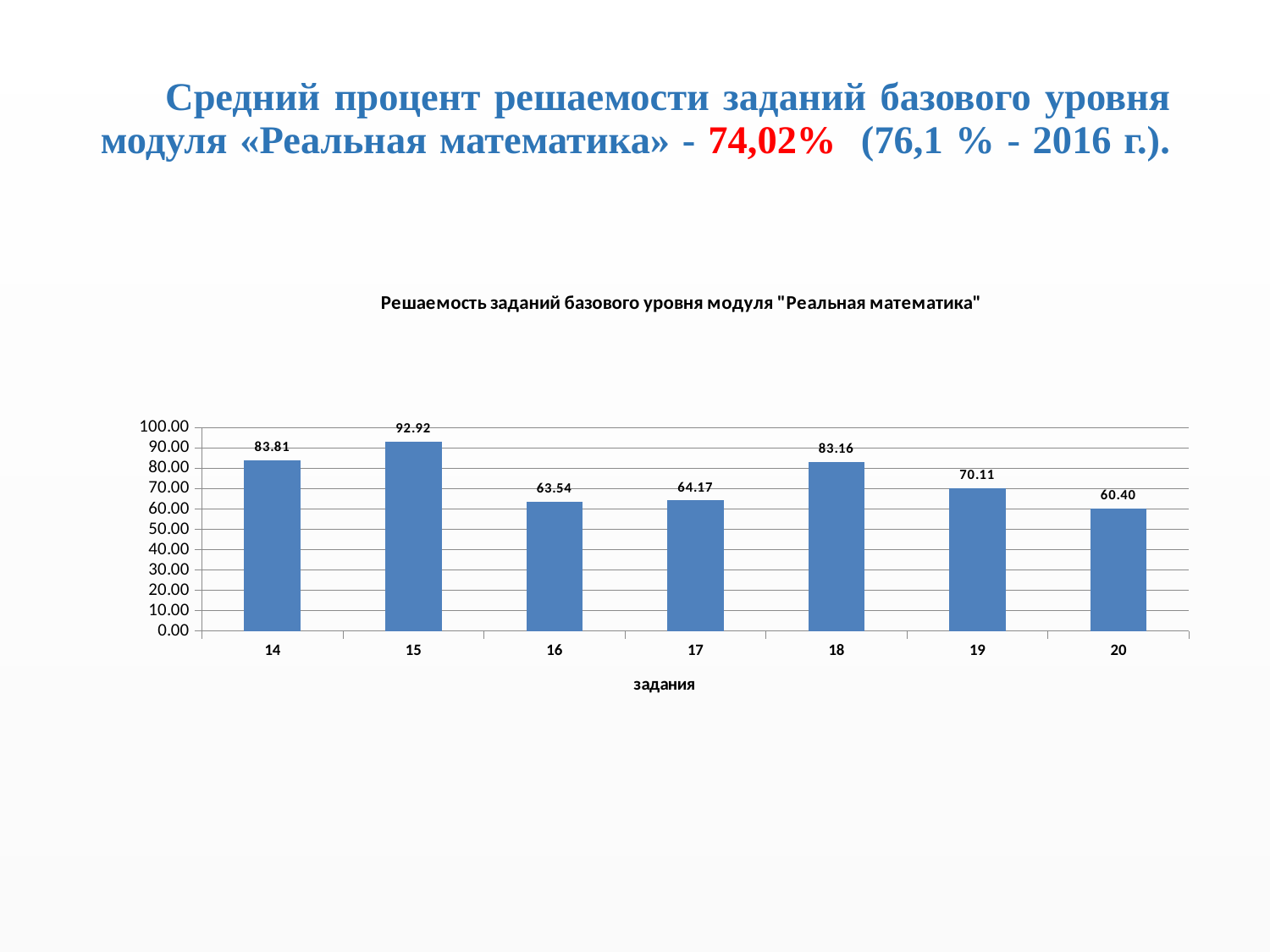
What is the value for task 17? 64.17 How many tasks are shown on the x axis? 7 What is the value for task 15? 92.92 Which task has the lowest value? 20 What kind of chart is shown on the slide? bar chart Which task has the highest value? 15 What is the difference between the values for task 15 and task 20? 32.52 What is the difference between the values for task 14 and task 18? 0.65 Is the value for task 18 greater or less than 80.00? greater What is the value for task 20? 60.40 Which is larger, the value for task 19 or the value for task 16? 19 What is the x-axis label of the chart? задания